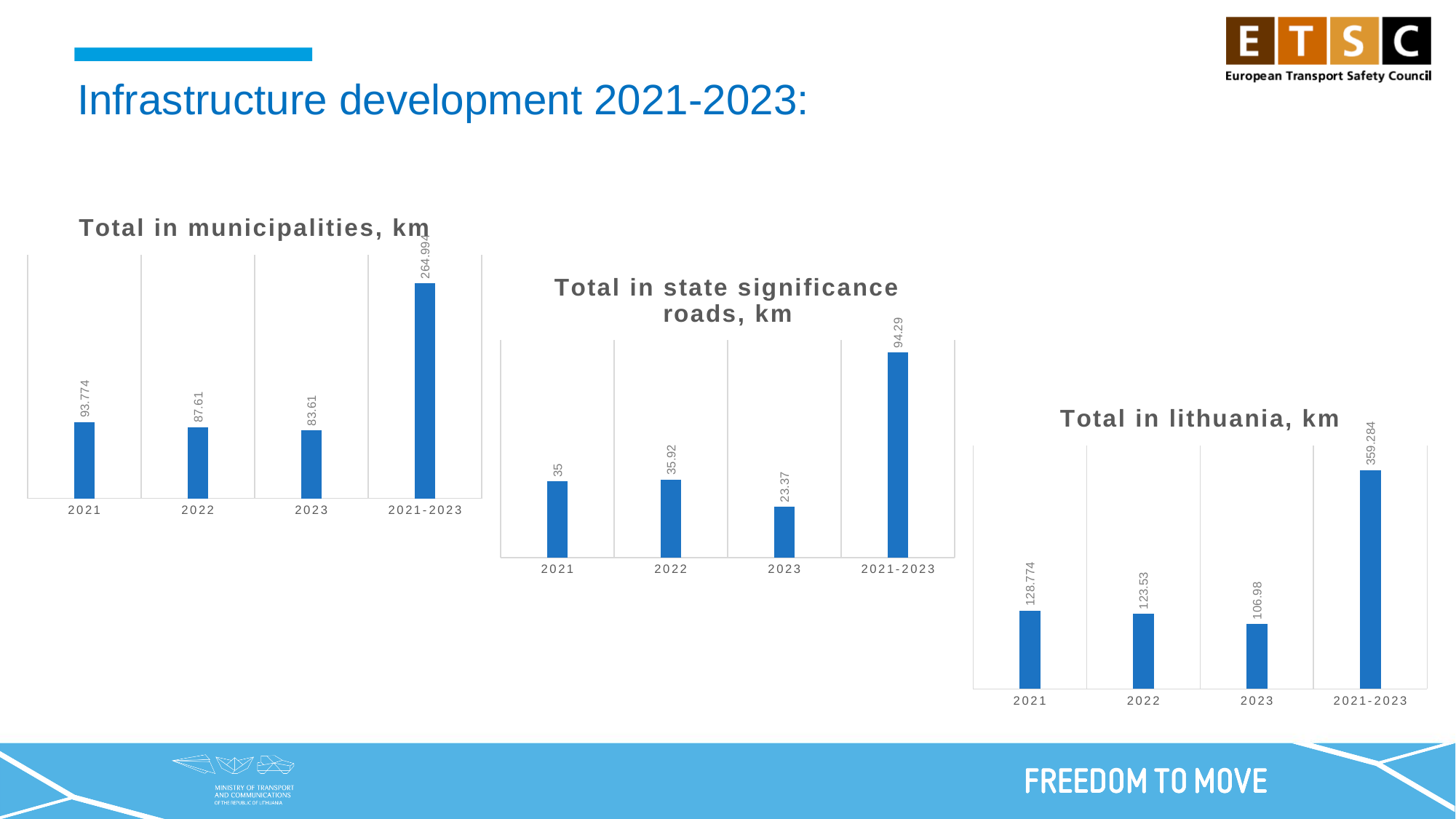
In the 'Total in municipalities, km' chart, what is the value for 2021? 93.774 In the 'Total in municipalities, km' chart, what is the value for 2021-2023? 264.994 In the 'Total in state significance roads, km' chart, what is the value for 2023? 23.37 In the 'Total in state significance roads, km' chart, which category has the lowest value? 2023 How many bars are shown in the 'Total in lithuania, km' chart? 4 What kind of chart is 'Total in state significance roads, km'? Bar chart In the 'Total in state significance roads, km' chart, which is larger, the value for 2022 or the value for 2023? 2022 In the 'Total in lithuania, km' chart, which category has the highest value? 2021-2023 In the 'Total in lithuania, km' chart, what is the value for 2022? 123.53 In the 'Total in municipalities, km' chart, what is the difference between the 2021 and 2022 values? 6.164 In the 'Total in lithuania, km' chart, what is the difference between the 2022 and 2023 values? 16.55 In the 'Total in municipalities, km' chart, do the values rise or fall from 2021 to 2023? Fall